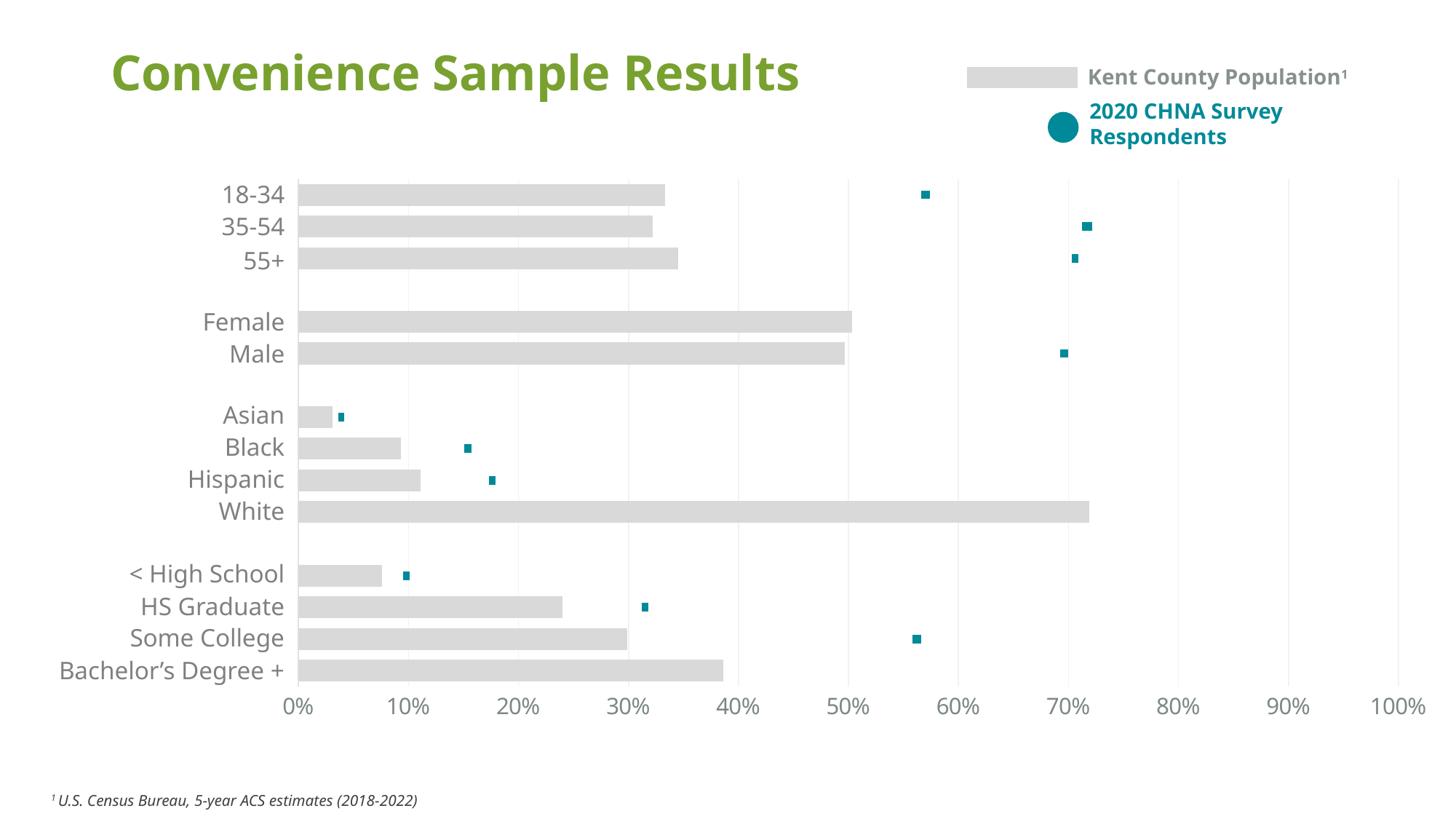
Which category has the lowest Kent County Population bar? Asian Is the 2020 CHNA Survey Respondents value for 18-34 greater or less than 50%? greater How many categories are plotted on the y axis? 13 What kind of chart is shown on the slide? bar chart Which is larger for 2020 CHNA Survey Respondents, 18-34 or 35-54? 35-54 Is the 2020 CHNA Survey Respondents value for Black greater or less than 10%? greater Which category has the highest Kent County Population bar? White What colour are the Kent County Population bars? gray How many series does the legend list? 2 Is the Kent County Population value for White greater or less than 60%? greater